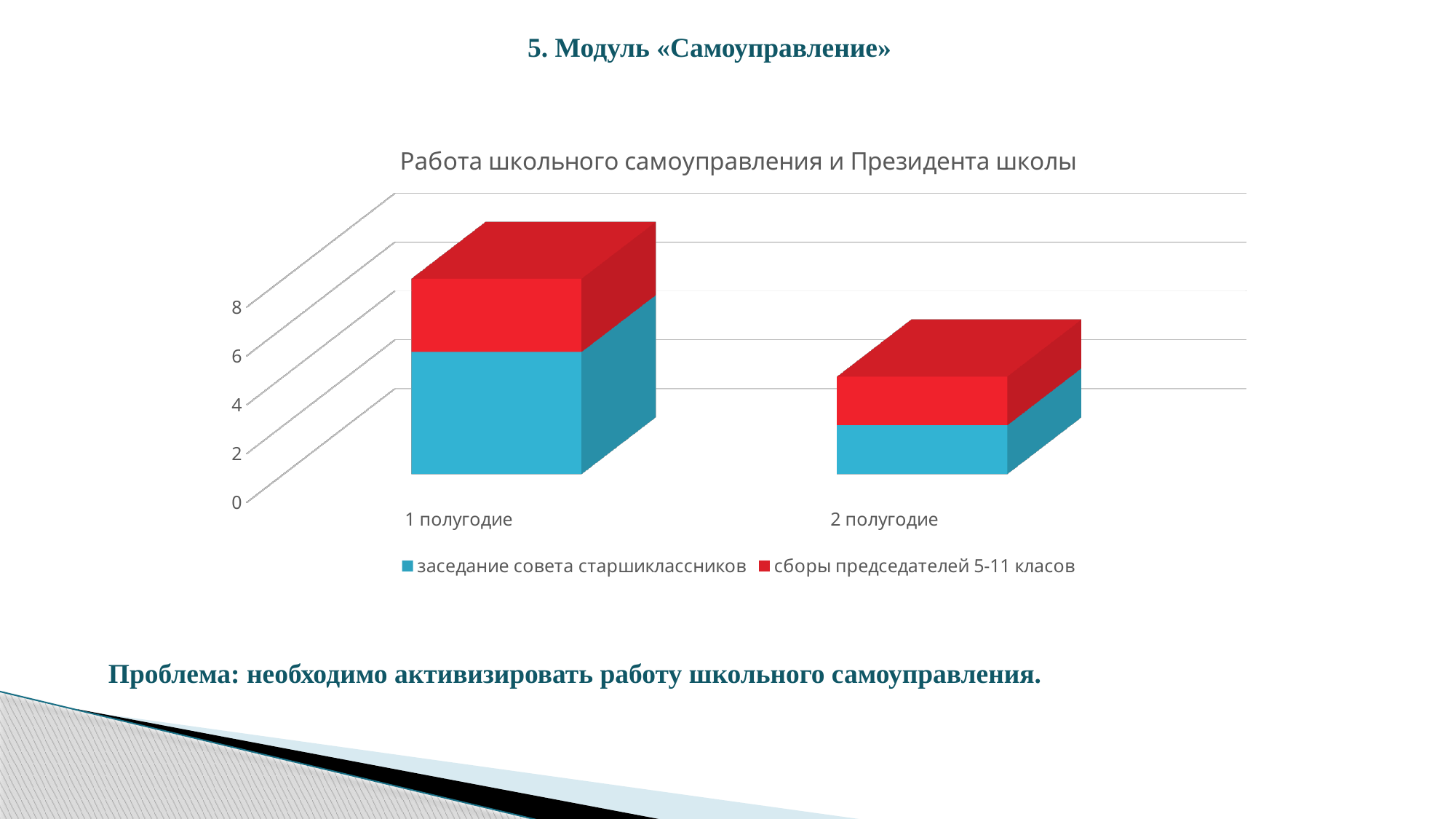
Do the stacked bar totals rise or fall from 1 полугодие to 2 полугодие? fall Is the value for заседание совета старшиклассников in 1 полугодие greater or less than 2? greater Is the total of the stacked bar for 1 полугодие greater or less than 6? greater Is the value for заседание совета старшиклассников in 2 полугодие greater or less than 4? less How many categories are shown on the x axis of the chart? 2 Which series is shown in red in the chart? сборы председателей 5-11 класов Which category has the lowest total stacked bar? 2 полугодие What kind of chart is shown on the slide? bar chart How many series does the chart legend list? 2 Which category has the highest total stacked bar? 1 полугодие Which category has the taller stacked bar, 1 полугодие or 2 полугодие? 1 полугодие What is the title of the chart? Работа школьного самоуправления и Президента школы